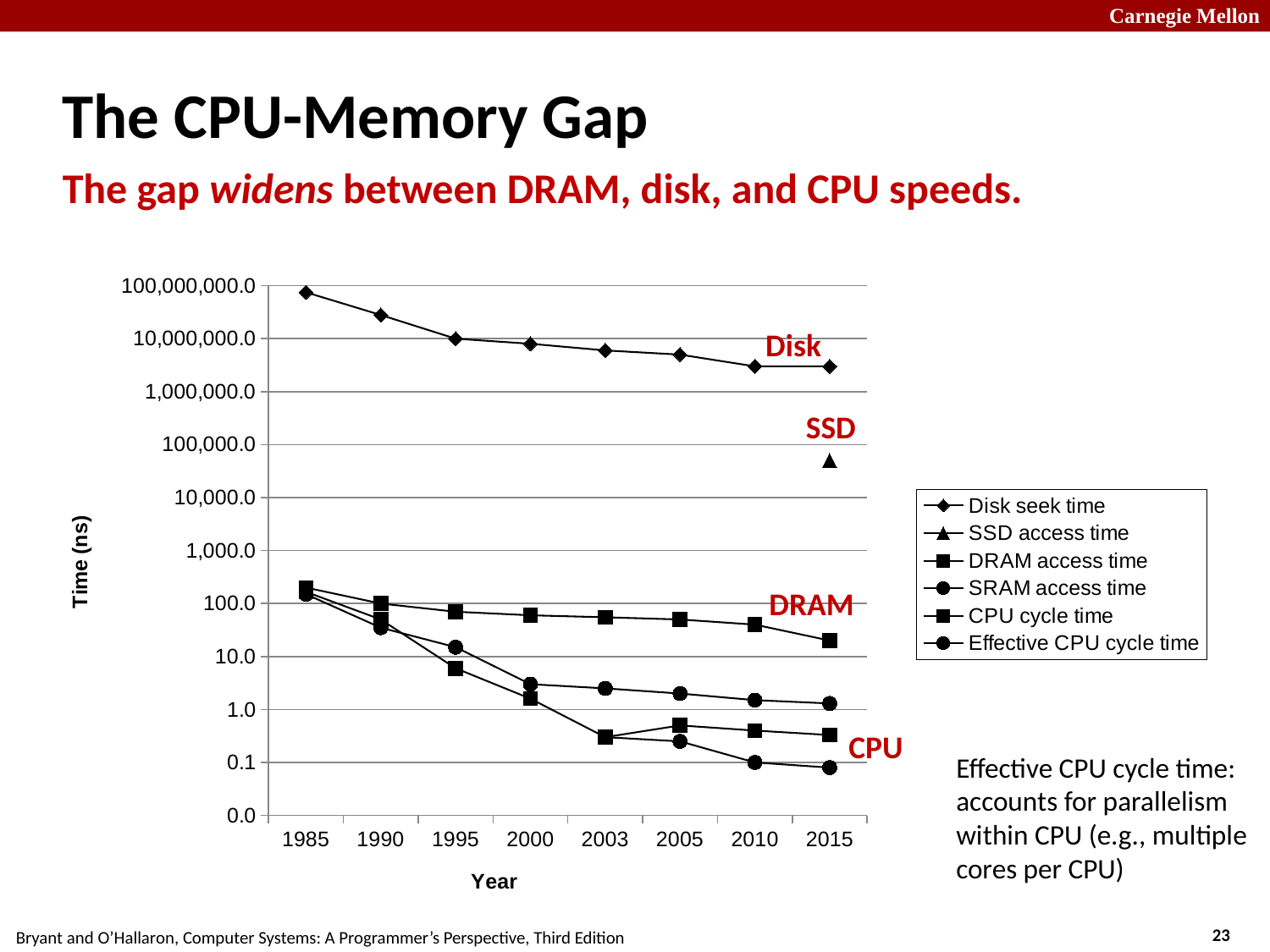
Which series has the lowest value in 2015? Effective CPU cycle time How many series does the legend list? 6 Which series has the highest value in 2015? Disk seek time Is the SSD access time in 2015 greater or less than 100,000.0? less What is the label on the y axis? Time (ns) What kind of chart is shown on the slide? line chart Is the Disk seek time in 1985 greater or less than 10,000,000.0? greater How many years are marked along the x axis? 8 Which is larger in 2015, the Disk seek time or the DRAM access time? Disk seek time Does the Disk seek time rise or fall from 1985 to 2015? fall Is the CPU cycle time in 2015 greater or less than 1.0? less